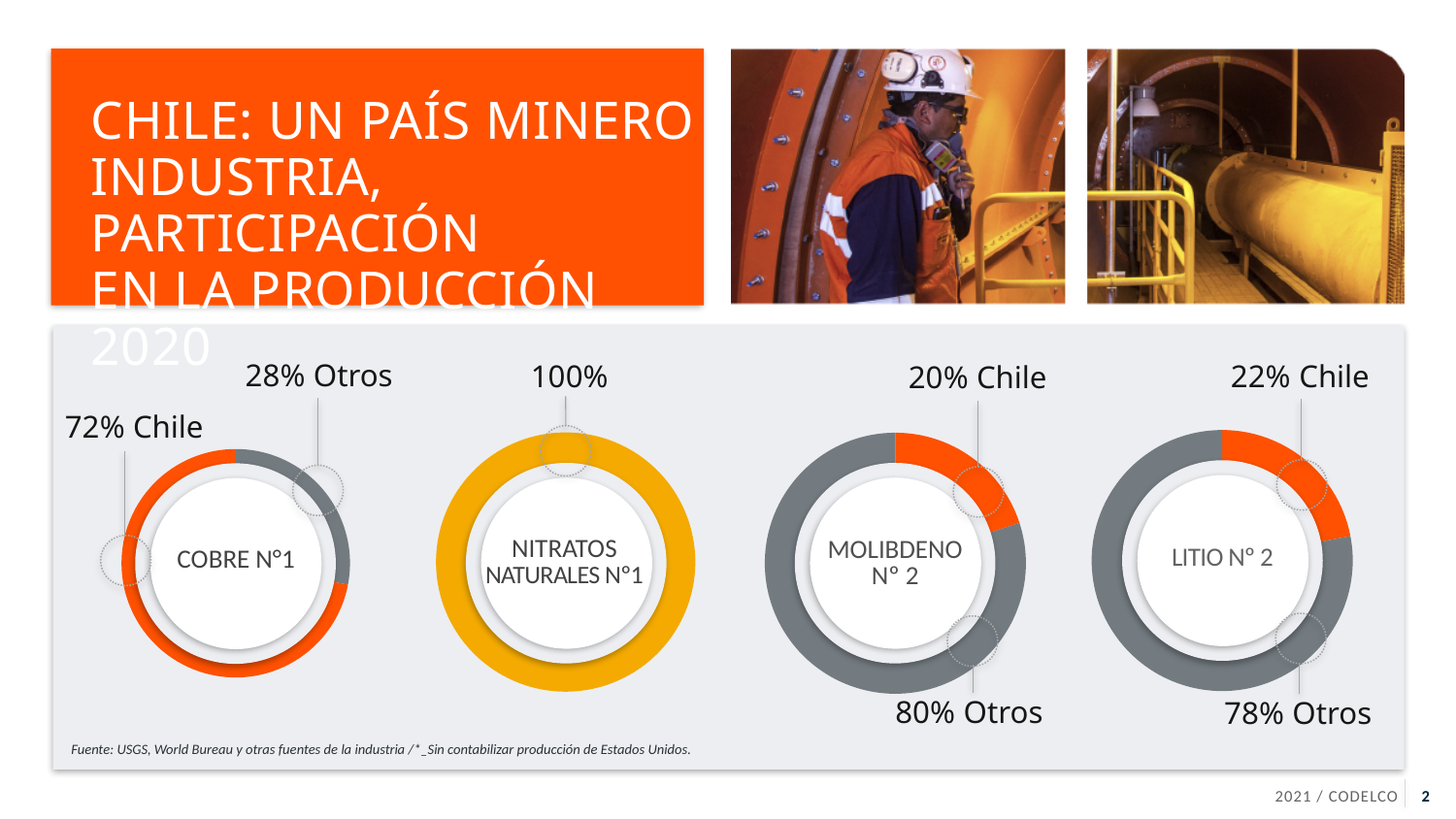
In the MOLIBDENO N° 2 donut chart, what share is labelled Chile? 20% Across the four donut charts, which mineral shows the highest Chile share? NITRATOS NATURALES N°1 In the NITRATOS NATURALES N°1 donut chart, what percentage is shown? 100% Which is larger: the Chile share in the LITIO N° 2 chart or the Chile share in the MOLIBDENO N° 2 chart? LITIO N° 2 In the LITIO N° 2 donut chart, what share is labelled Otros? 78% How many donut charts are shown on the slide? 4 In the COBRE N°1 donut chart, what share is labelled Otros? 28% In the COBRE N°1 donut chart, what share of production is labelled Chile? 72% In the MOLIBDENO N° 2 donut chart, what share is labelled Otros? 80% In the LITIO N° 2 donut chart, what share is labelled Chile? 22% Across the four donut charts, which mineral shows the lowest Chile share? MOLIBDENO N° 2 What is the difference between the Chile share in the COBRE N°1 chart and the Chile share in the LITIO N° 2 chart? 50%